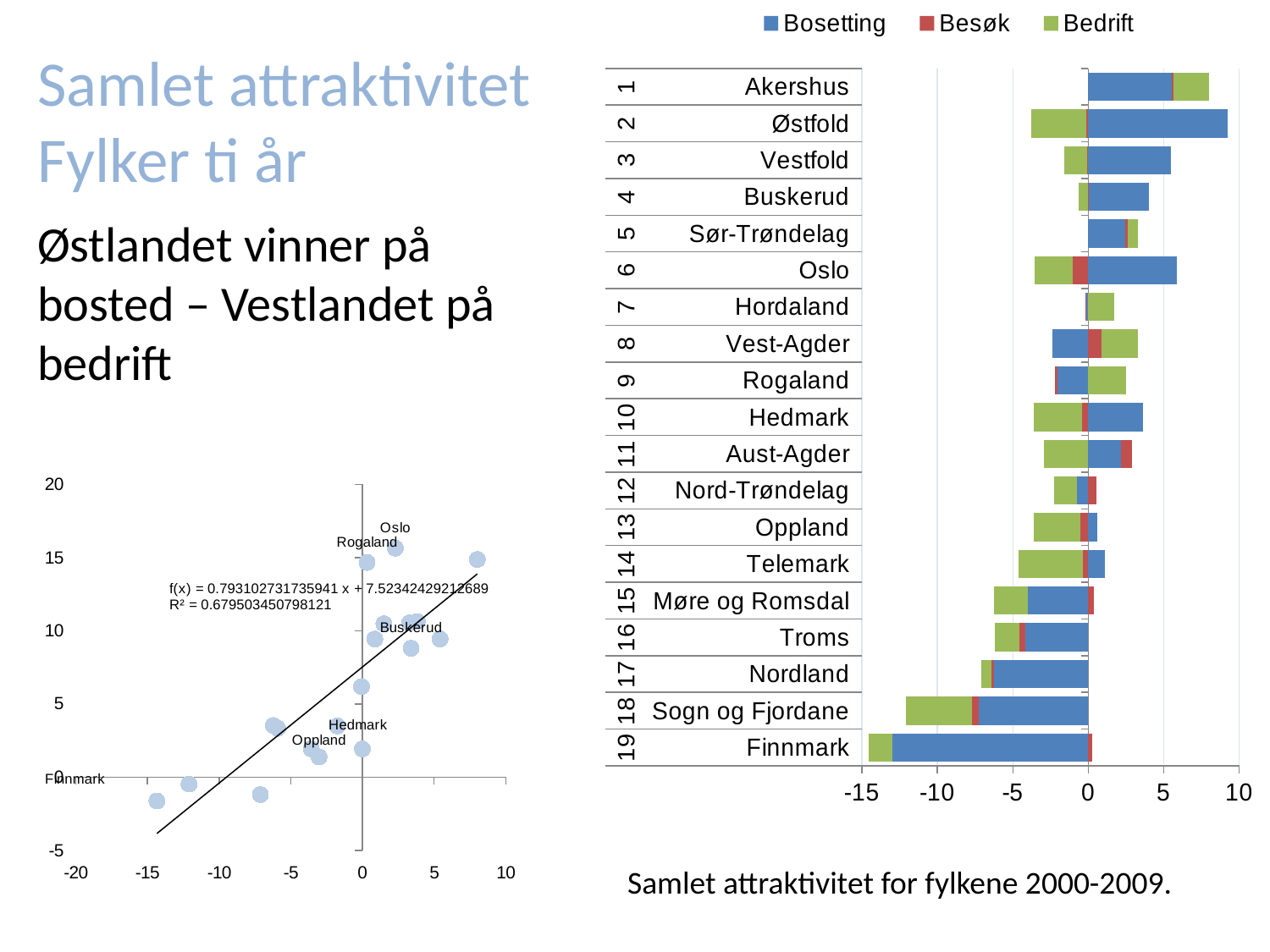
What kind of chart is the chart on the right of the slide? bar chart How many series does the legend of the bar chart on the right list? 3 In the bar chart on the right, is the Bosetting value for Østfold greater or less than 5? greater In the bar chart on the right, which county has the larger Bosetting value, Østfold or Akershus? Østfold In the bar chart on the right, which county is ranked number 1? Akershus In the bar chart on the right, which county is ranked number 19? Finnmark In the bar chart on the right, is the Bedrift value for Telemark greater or less than 0? less What kind of chart is the chart at the bottom left of the slide? scatter chart How many counties (categories) are shown in the bar chart on the right? 19 In the scatter chart at the bottom left, what R² value is printed for the trendline? 0.679503450798121 In the bar chart on the right, is the Bosetting value for Finnmark greater or less than -10? less